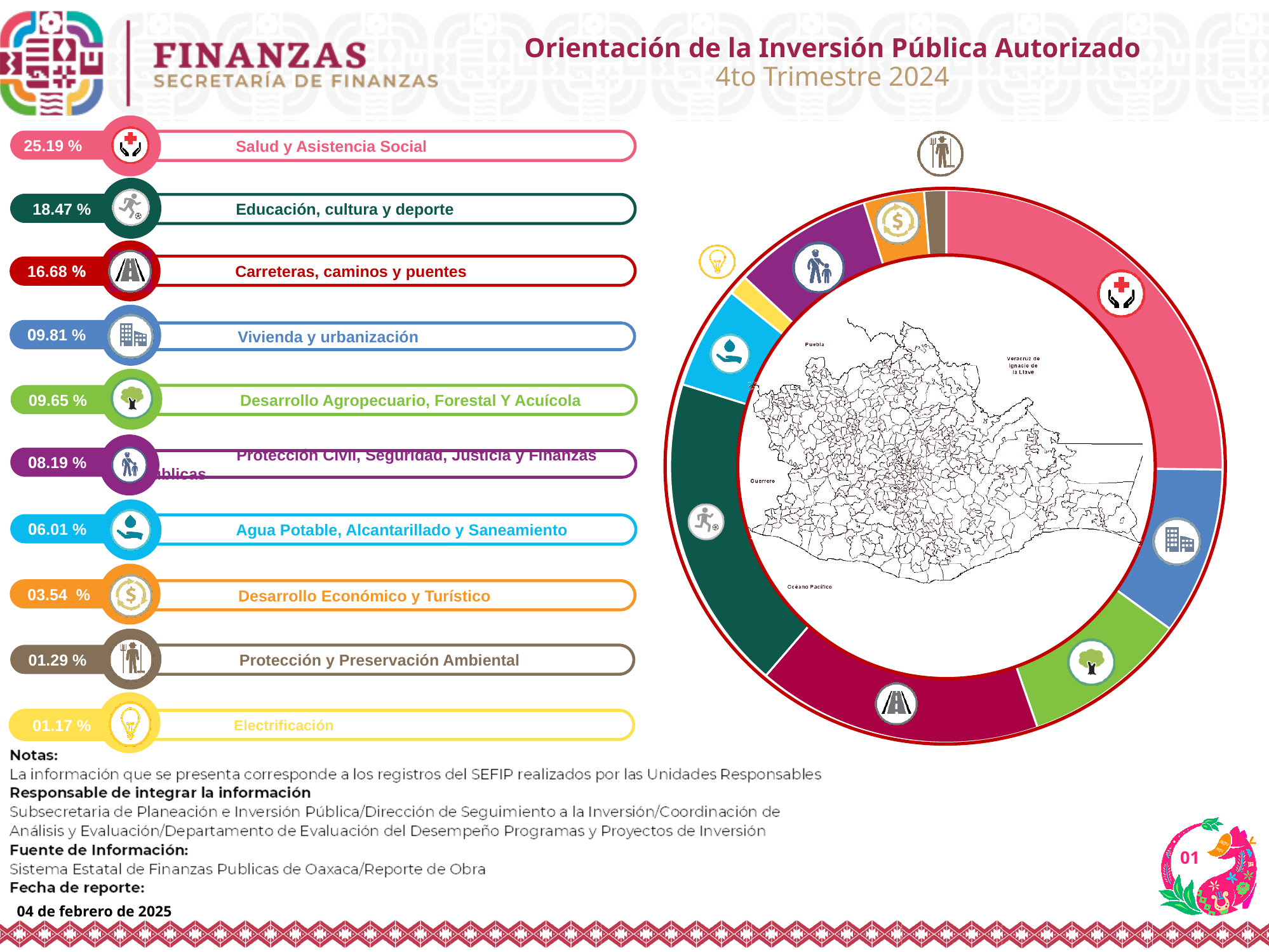
What percentage is shown for Desarrollo Económico y Turístico? 03.54 % How many categories are shown in the chart? 10 What percentage is shown for Salud y Asistencia Social? 25.19 % What percentage is shown for Agua Potable, Alcantarillado y Saneamiento? 06.01 % What is the difference in percentage points between Protección y Preservación Ambiental and Electrificación? 0.12 Which category has the largest share of the authorized public investment? Salud y Asistencia Social What kind of chart is shown on the slide? Donut (pie) chart What is the difference in percentage points between Salud y Asistencia Social and Educación, cultura y deporte? 6.72 Which category has the smallest share of the authorized public investment? Electrificación What is the title of the slide? Orientación de la Inversión Pública Autorizado 4to Trimestre 2024 Which has a larger share: Vivienda y urbanización or Desarrollo Agropecuario, Forestal Y Acuícola? Vivienda y urbanización What percentage is shown for Carreteras, caminos y puentes? 16.68 %